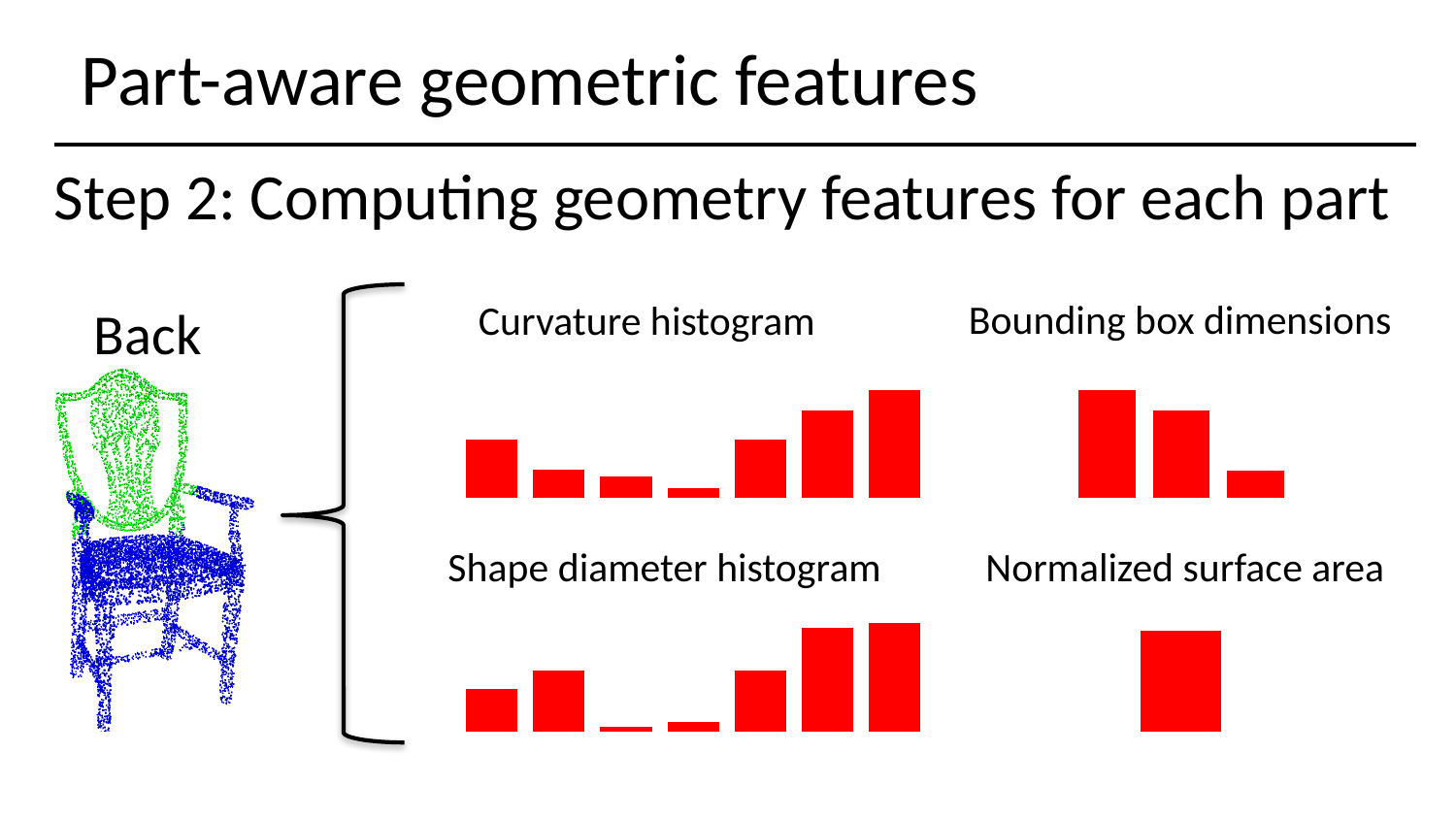
What colour are the bars in the four charts on the slide? red How many bars does the Normalized surface area chart have? 1 How many bars does the Curvature histogram chart have? 7 In the Bounding box dimensions chart, is the first bar from the left taller or shorter than the second bar? taller What is the title of the chart in the top-right position of the slide? Bounding box dimensions How many bars does the Bounding box dimensions chart have? 3 In the Bounding box dimensions chart, do the bar heights rise or fall from left to right? fall In the Shape diameter histogram chart, is the second bar from the left taller or shorter than the third bar? taller In the Curvature histogram chart, which bar is the tallest: the leftmost or the rightmost? rightmost In the Bounding box dimensions chart, which bar is the shortest: the first, second or third from the left? third What kind of chart is the Curvature histogram? bar chart